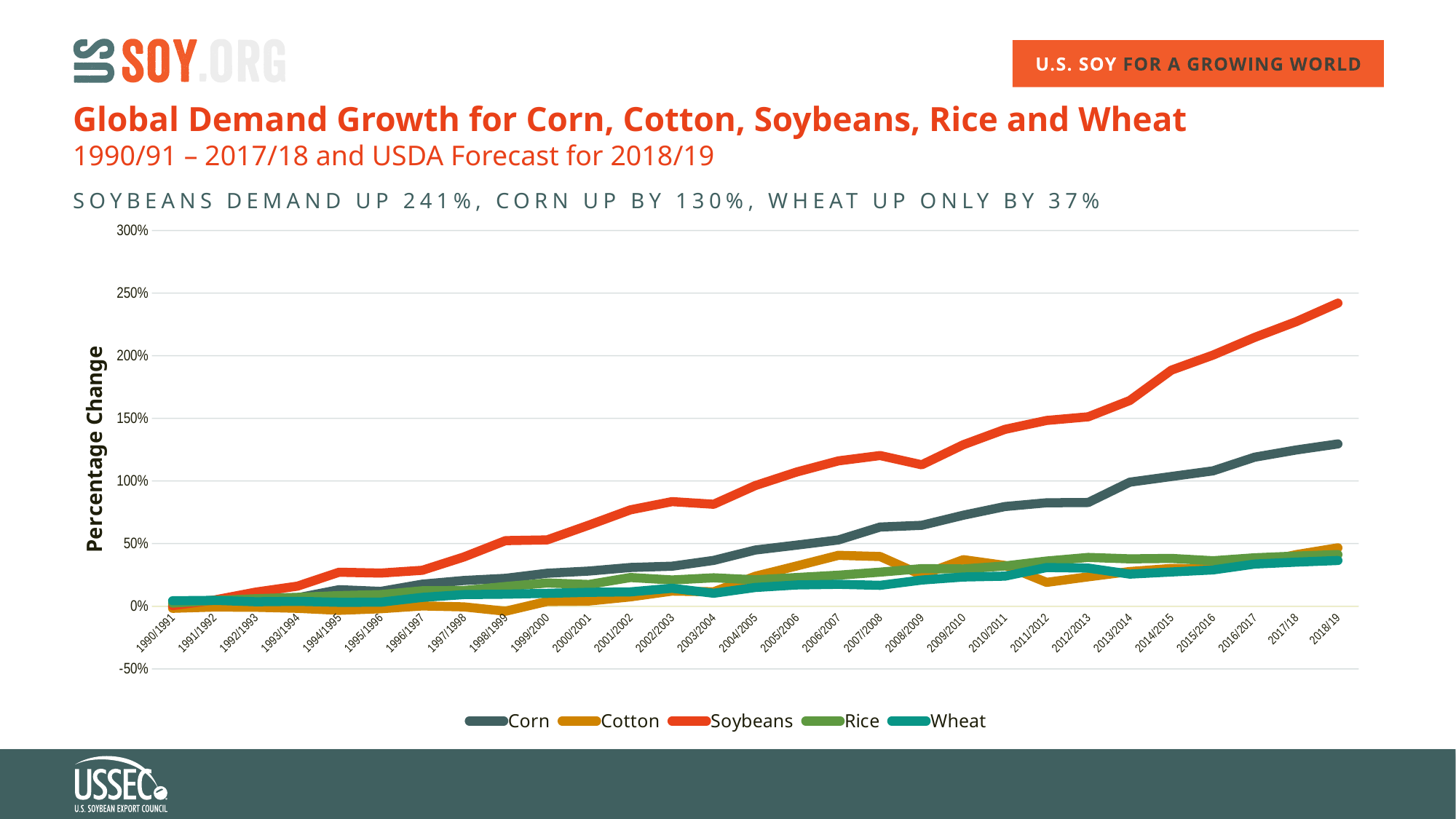
What is the difference between the soybean demand growth and the corn demand growth stated on the slide? 111% Which is larger in 2018/19, the value for Corn or the value for Soybeans? Soybeans By what percentage is soybean demand up, according to the slide? 241% How many series does the legend list? 5 By what percentage is corn demand up, according to the slide? 130% What kind of chart is shown on the slide? line chart Which series has the highest value in 2018/19? Soybeans What is the label on the vertical axis? Percentage Change How many marketing years are plotted along the x axis? 29 By what percentage is wheat demand up, according to the slide? 37% Is the value for Soybeans in 2010/2011 greater or less than 100%? greater Is the value for Corn in 2000/2001 greater or less than 50%? less